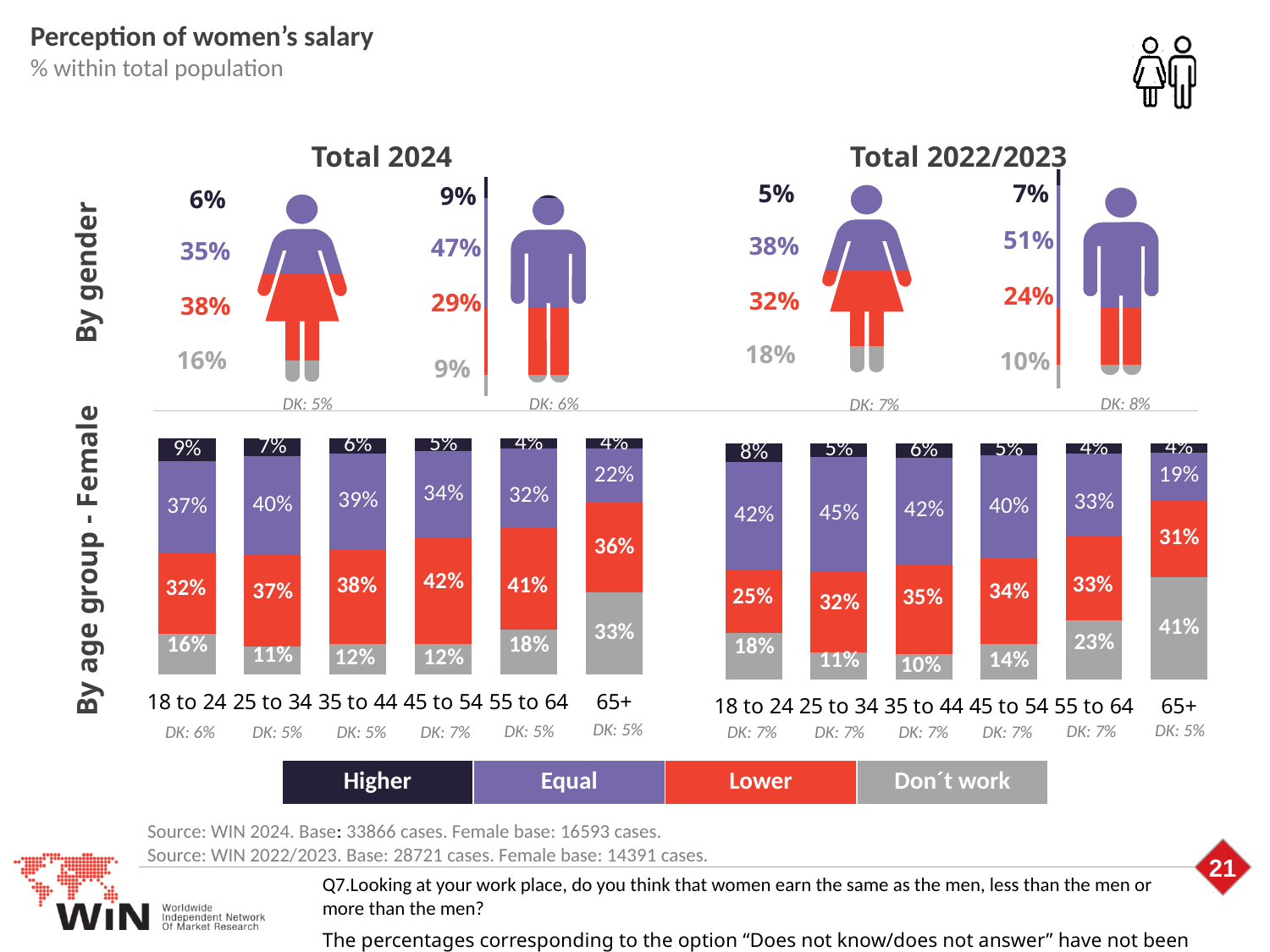
In the By age group - Female 2024 bar chart, which age group has the highest Don't work value? 65+ In the Total 2024 chart, what is the difference between the Equal percentage for men and for women? 12% How many categories does the legend at the bottom of the slide list? 4 In the Total 2022/2023 chart, what percentage of men say women's salary is Higher? 7% In the By age group - Female 2022/2023 bar chart, what is the Don't work value for the 65+ age group? 41% In the Total 2024 chart, what percentage of men say women's salary is Equal? 47% In the By age group - Female 2024 bar chart, what is the Lower value for the 45 to 54 age group? 42% How many age groups are shown in the By age group - Female 2024 bar chart? 6 In the By age group - Female 2022/2023 bar chart, which age group has the lowest Equal value? 65+ In the Total 2024 chart, what percentage of women say women's salary is Lower? 38% What type of chart is used for the By age group - Female section? Stacked bar chart In the By age group - Female 2024 bar chart, is the Lower value for 25 to 34 larger or smaller than the Lower value for 55 to 64? smaller